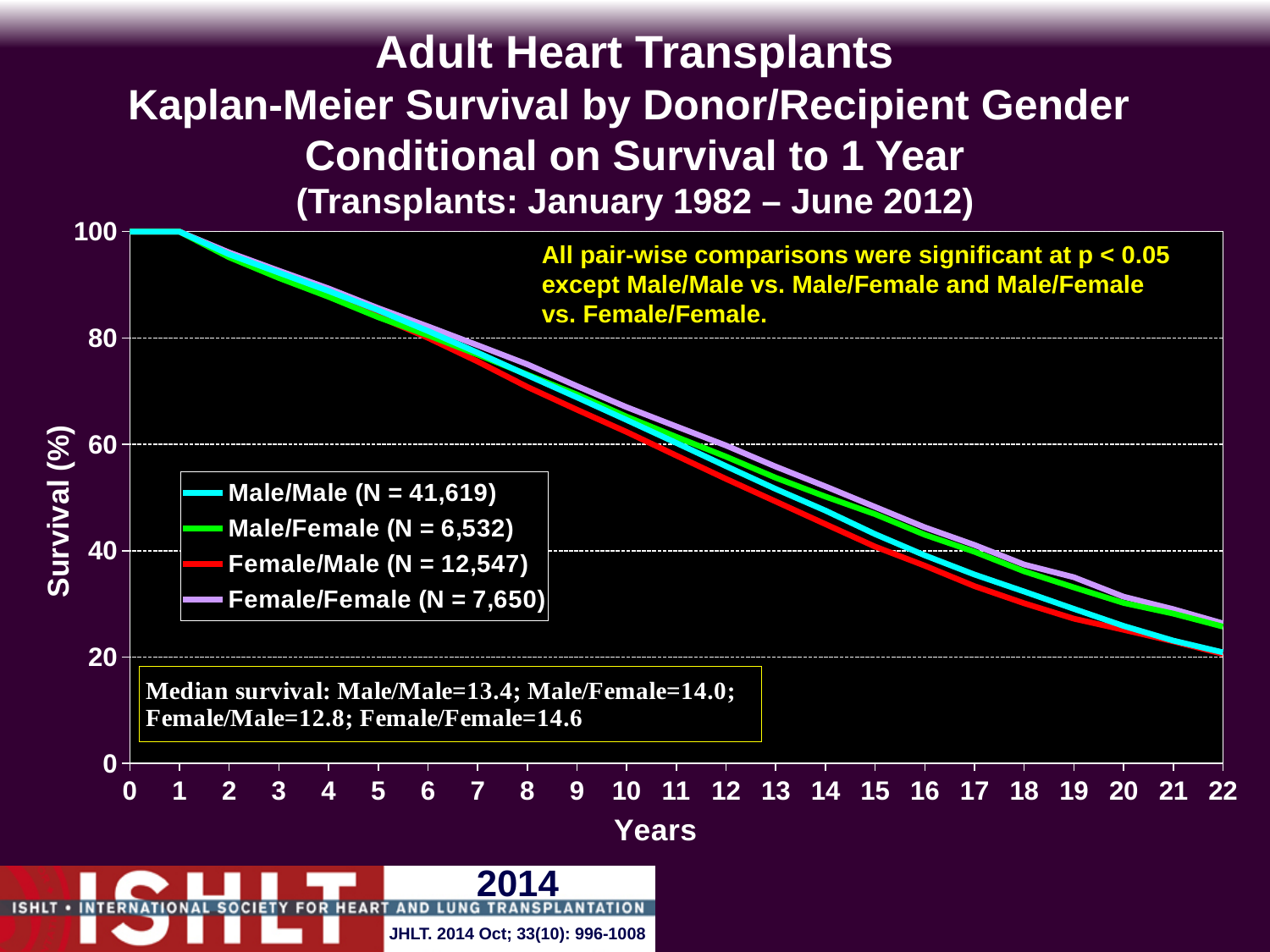
What is the difference in median survival between the Female/Female and Female/Male groups? 1.8 Which donor/recipient group has the lowest median survival? Female/Male What kind of chart is shown on the slide? line chart How many donor/recipient gender groups does the legend list? 4 Is the Male/Male survival at 22 years greater or less than 40? less What is the N for the Male/Male group in the legend? 41,619 Which donor/recipient group has the highest median survival? Female/Female Do the survival curves rise or fall as years increase? fall What colour is the Female/Male line? red Which has the larger median survival, Male/Male or Male/Female? Male/Female What is the median survival for the Female/Female group? 14.6 What is the N for the Female/Male group in the legend? 12,547